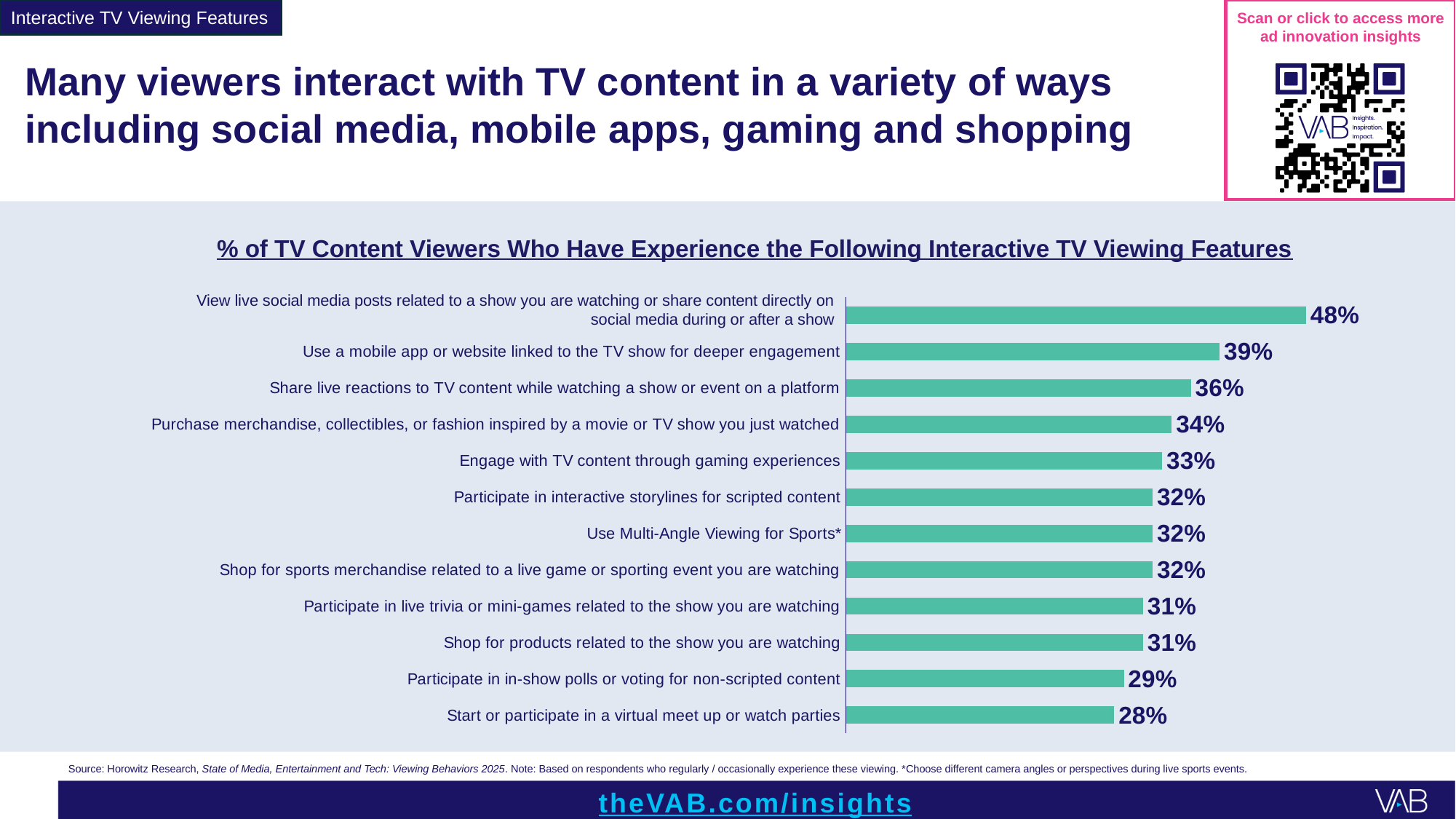
What percentage of TV content viewers have engaged with TV content through gaming experiences? 33% What type of chart is used on this slide? Bar chart Which interactive TV viewing feature has the lowest percentage of viewers who have experienced it? Start or participate in a virtual meet up or watch parties How many features in the chart have a value of exactly 32%? 3 Which has a higher percentage: sharing live reactions to TV content while watching a show or event on a platform, or participating in live trivia or mini-games related to the show? Share live reactions to TV content while watching a show or event on a platform What percentage of TV content viewers have started or participated in a virtual meet up or watch parties? 28% What is the title of the chart on this slide? % of TV Content Viewers Who Have Experience the Following Interactive TV Viewing Features What is the difference in percentage points between purchasing merchandise inspired by a movie or TV show (34%) and participating in in-show polls or voting for non-scripted content (29%)? 5 percentage points What is the difference in percentage points between viewing live social media posts related to a show (48%) and using a mobile app or website linked to the TV show (39%)? 9 percentage points How many interactive TV viewing features are listed in the chart? 12 What percentage of TV content viewers have used a mobile app or website linked to the TV show for deeper engagement? 39% Which interactive TV viewing feature has the highest percentage of viewers who have experienced it? View live social media posts related to a show you are watching or share content directly on social media during or after a show